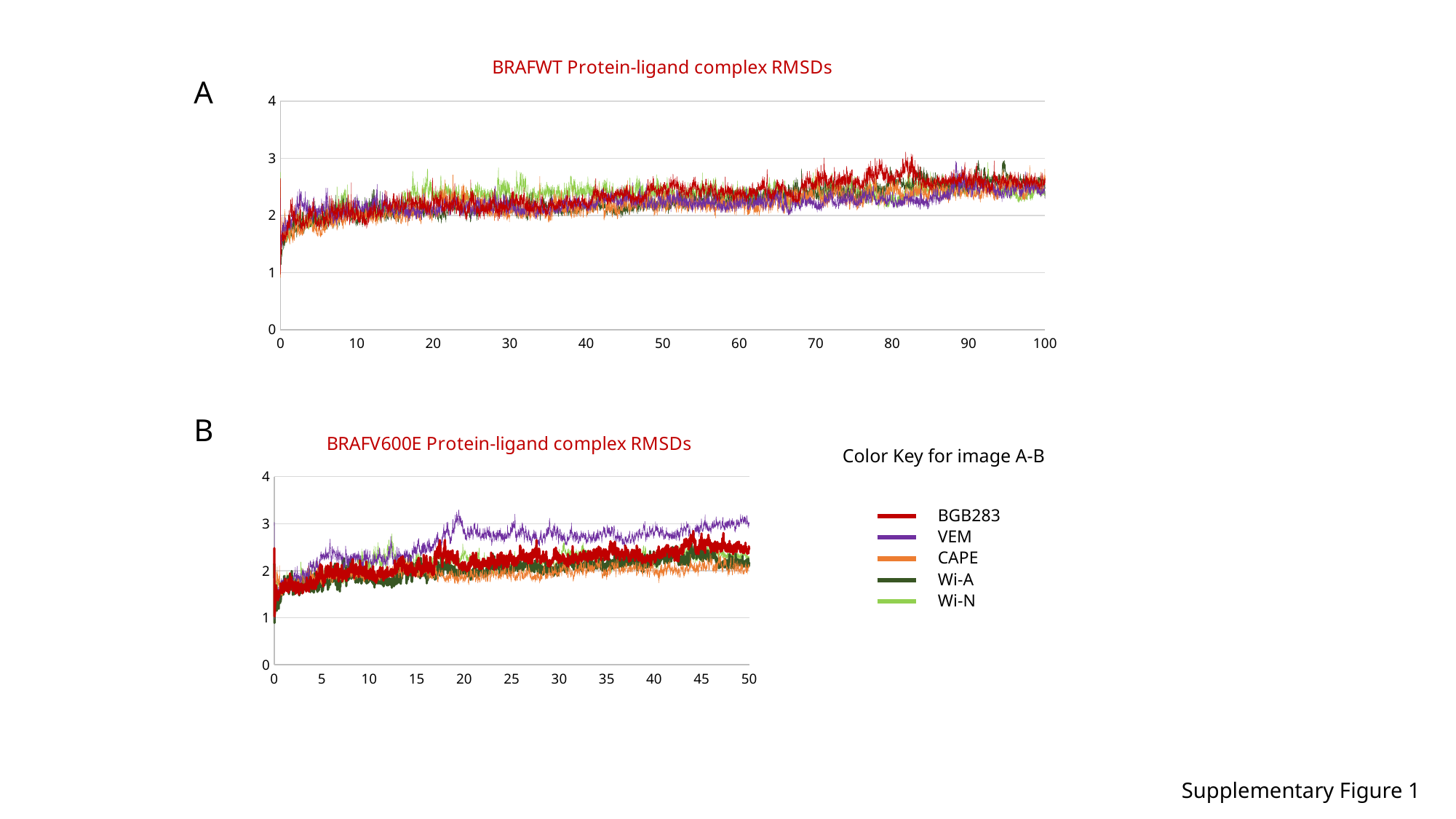
In the Color Key for image A-B, which series is drawn in purple? VEM What is the title of the top chart (A)? BRAFWT Protein-ligand complex RMSDs In the BRAFWT Protein-ligand complex RMSDs chart, is the value for BGB283 at x = 50 greater or less than 3? less In the BRAFV600E Protein-ligand complex RMSDs chart, at x = 45, which is larger: the value for VEM or the value for CAPE? VEM In the BRAFV600E Protein-ligand complex RMSDs chart, is the value for CAPE at x = 40 greater or less than 3? less In the BRAFWT Protein-ligand complex RMSDs chart, is the value for Wi-N at x = 30 greater or less than 1? greater In the BRAFV600E Protein-ligand complex RMSDs chart, do the values generally rise or fall along the x axis? rise In the BRAFWT Protein-ligand complex RMSDs chart, do the values generally rise or fall from x = 0 to x = 100? rise How many series does the Color Key for image A-B list? 5 What kind of chart is the BRAFWT Protein-ligand complex RMSDs chart? line chart In the BRAFV600E Protein-ligand complex RMSDs chart, which series has the highest values between x = 20 and x = 50? VEM